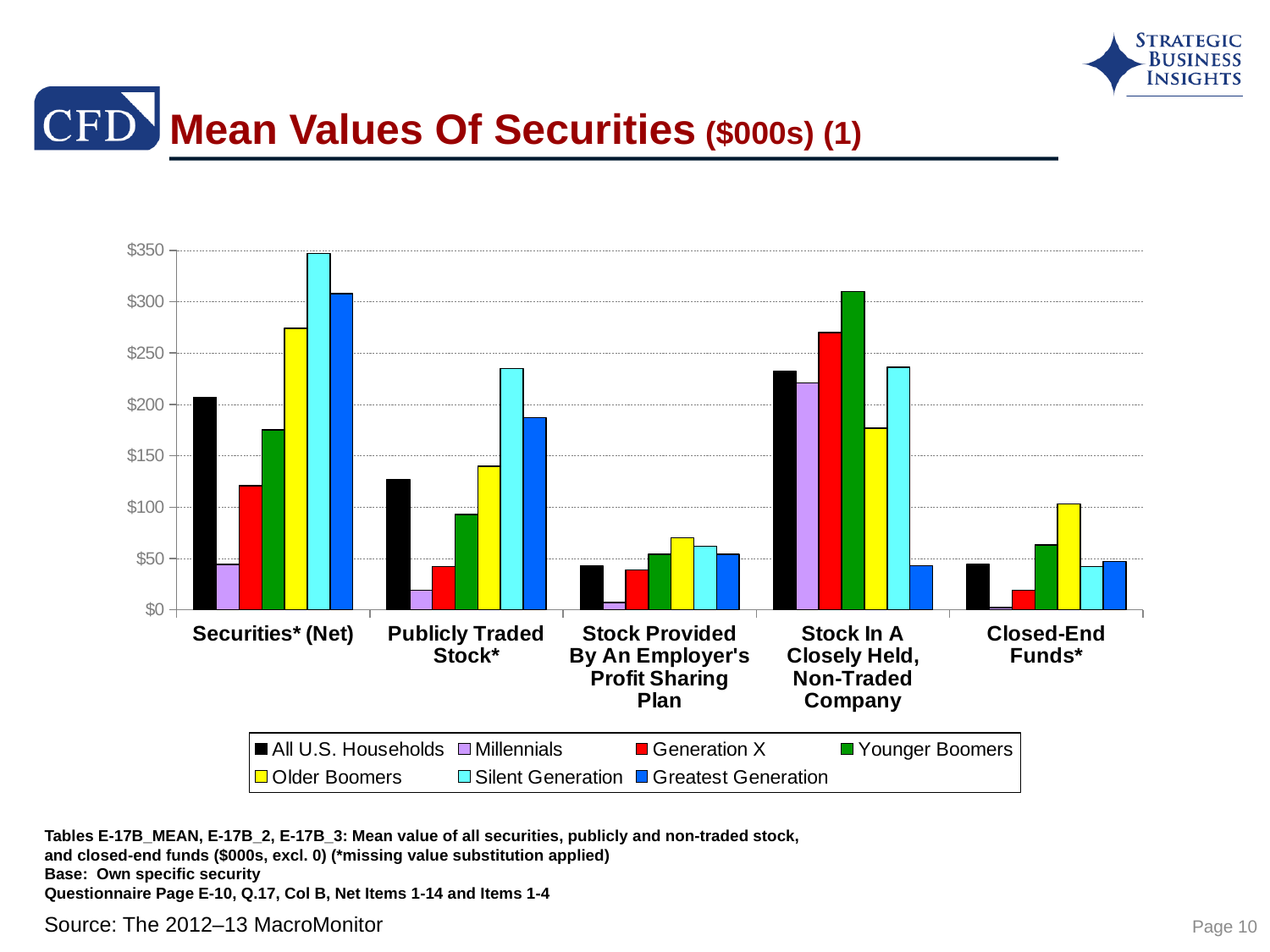
What kind of chart is shown on the slide? Bar chart How many security categories are shown along the x axis? 5 Which series has the highest value for Stock In A Closely Held, Non-Traded Company? Younger Boomers Which series has the highest value for Securities* (Net)? Silent Generation Which series has the lowest value for Closed-End Funds*? Millennials Is the value for Greatest Generation in Stock In A Closely Held, Non-Traded Company greater or less than $100? less Which series has the highest value for Closed-End Funds*? Older Boomers What is the title of the chart? Mean Values Of Securities ($000s) (1) How many series does the legend list? 7 For Closed-End Funds*, which is larger: Older Boomers or Silent Generation? Older Boomers Is the value for Silent Generation in Publicly Traded Stock* greater or less than $200? greater Is the value for All U.S. Households in Securities* (Net) greater or less than $150? greater